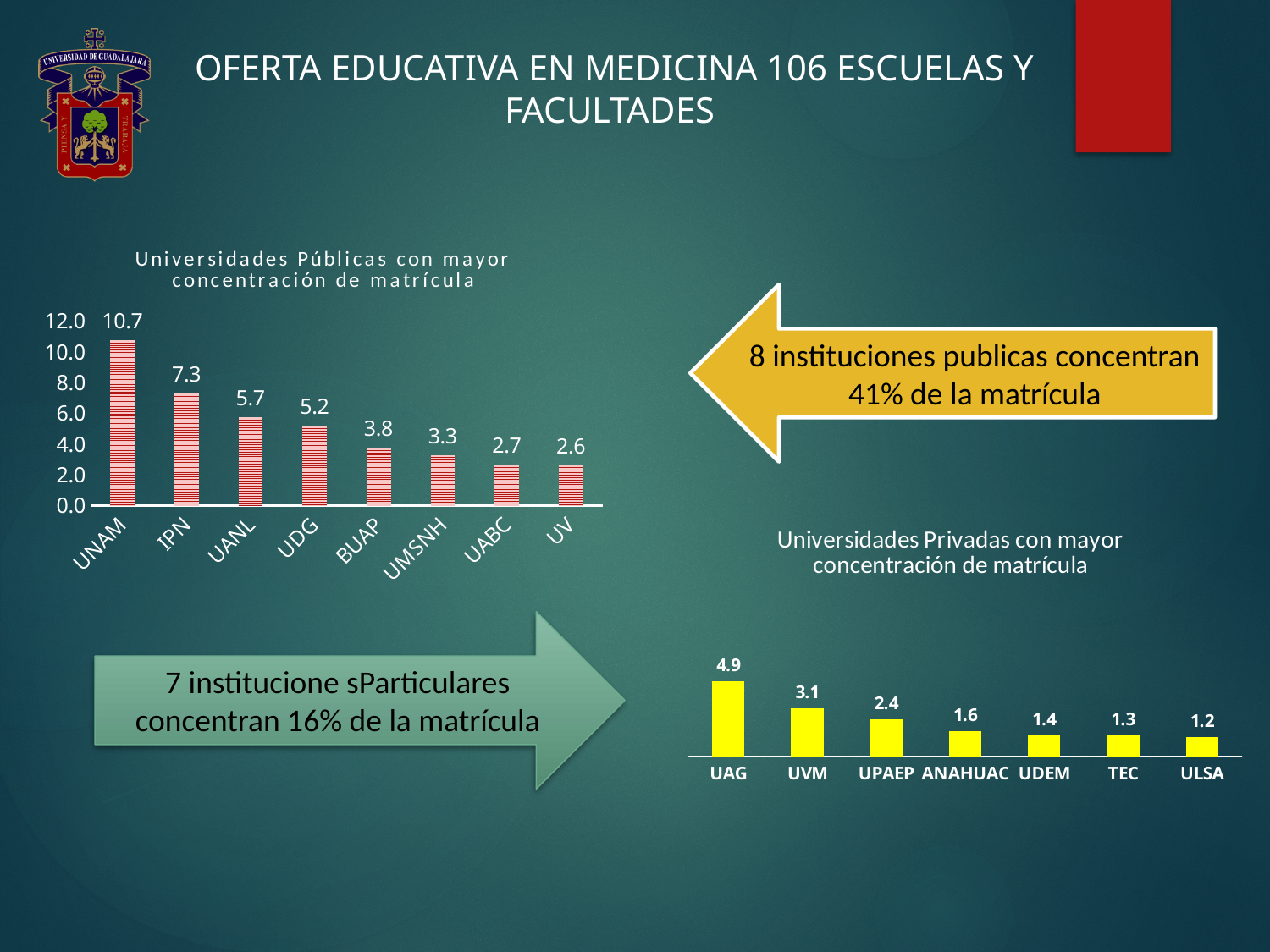
In the 'Universidades Públicas con mayor concentración de matrícula' chart, what is the difference between the values for UNAM and IPN? 3.4 In the 'Universidades Públicas con mayor concentración de matrícula' chart, what is the value for UDG? 5.2 In the 'Universidades Públicas con mayor concentración de matrícula' chart, how many universities are shown? 8 In the 'Universidades Públicas con mayor concentración de matrícula' chart, which university has the lowest value? UV What colour are the bars in the 'Universidades Privadas con mayor concentración de matrícula' chart? yellow In the 'Universidades Privadas con mayor concentración de matrícula' chart, which university has the highest value? UAG In the 'Universidades Privadas con mayor concentración de matrícula' chart, what is the value for UVM? 3.1 What kind of chart is the 'Universidades Privadas con mayor concentración de matrícula' chart? bar chart In the 'Universidades Públicas con mayor concentración de matrícula' chart, what is the value for UNAM? 10.7 In the 'Universidades Públicas con mayor concentración de matrícula' chart, do the values rise or fall from left to right? fall In the 'Universidades Privadas con mayor concentración de matrícula' chart, which is larger, the value for UPAEP or the value for ANAHUAC? UPAEP In the 'Universidades Privadas con mayor concentración de matrícula' chart, how many universities are shown? 7